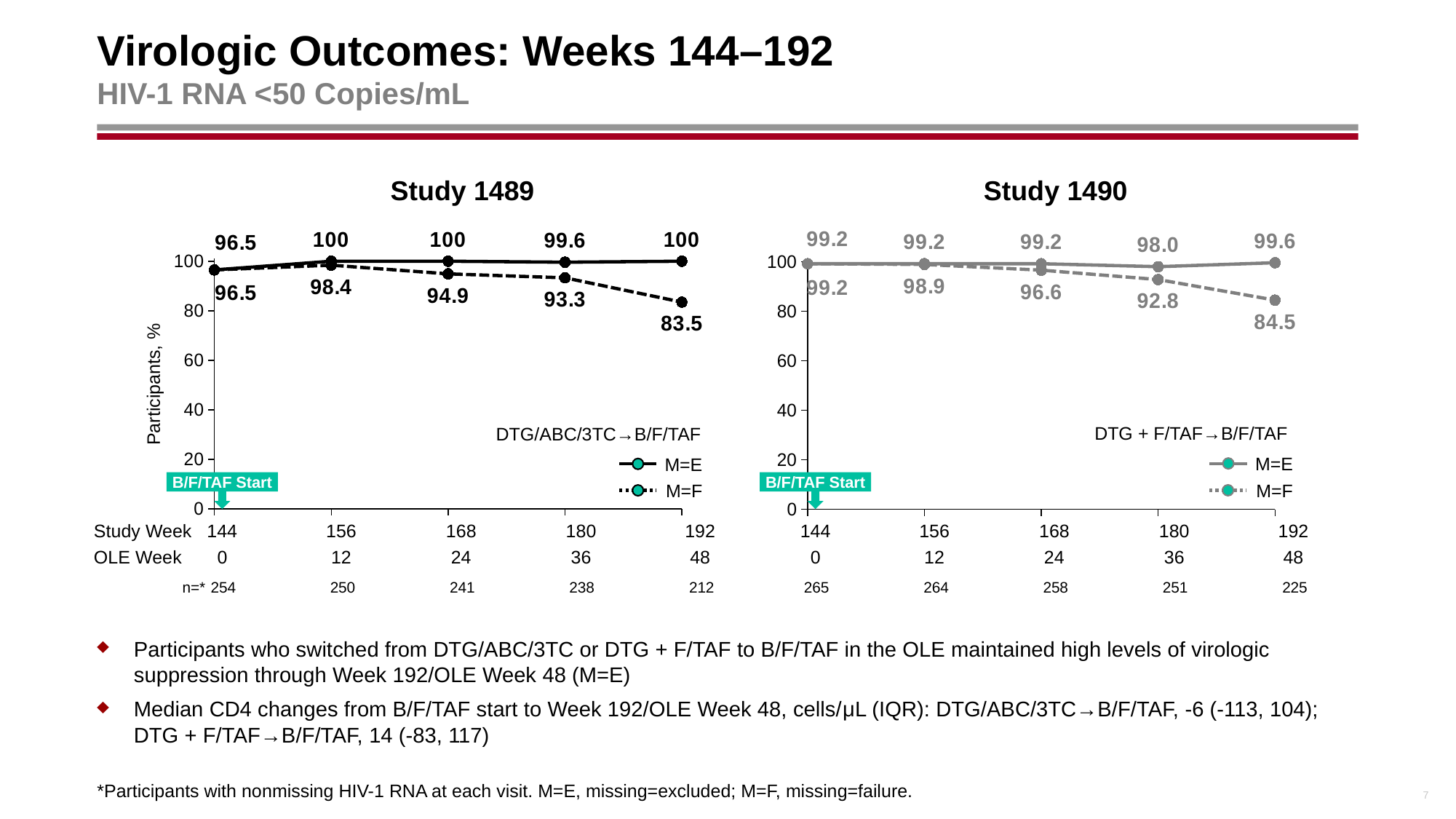
In the Study 1489 chart, does the M=F series rise or fall from study week 156 to study week 192? fall In the Study 1490 chart, at which study week is the M=E value lowest? 180 In the Study 1489 chart, what is the M=E value at study week 180? 99.6 In the Study 1489 chart, what is the M=F value at study week 192? 83.5 In the Study 1490 chart, what is the M=F value at study week 180? 92.8 In the Study 1489 chart, at which study week is the M=F value lowest? 192 In the Study 1490 chart, what is the difference between the M=F values at study week 144 and study week 192? 14.7 How many study week points are plotted in the Study 1490 chart? 5 What kind of chart is the Study 1489 chart? line chart In the Study 1490 chart, what is the M=E value at study week 192? 99.6 In the Study 1490 chart, which is larger at study week 168: the M=E value or the M=F value? M=E In the Study 1489 chart, what is the difference between the M=E and M=F values at study week 192? 16.5